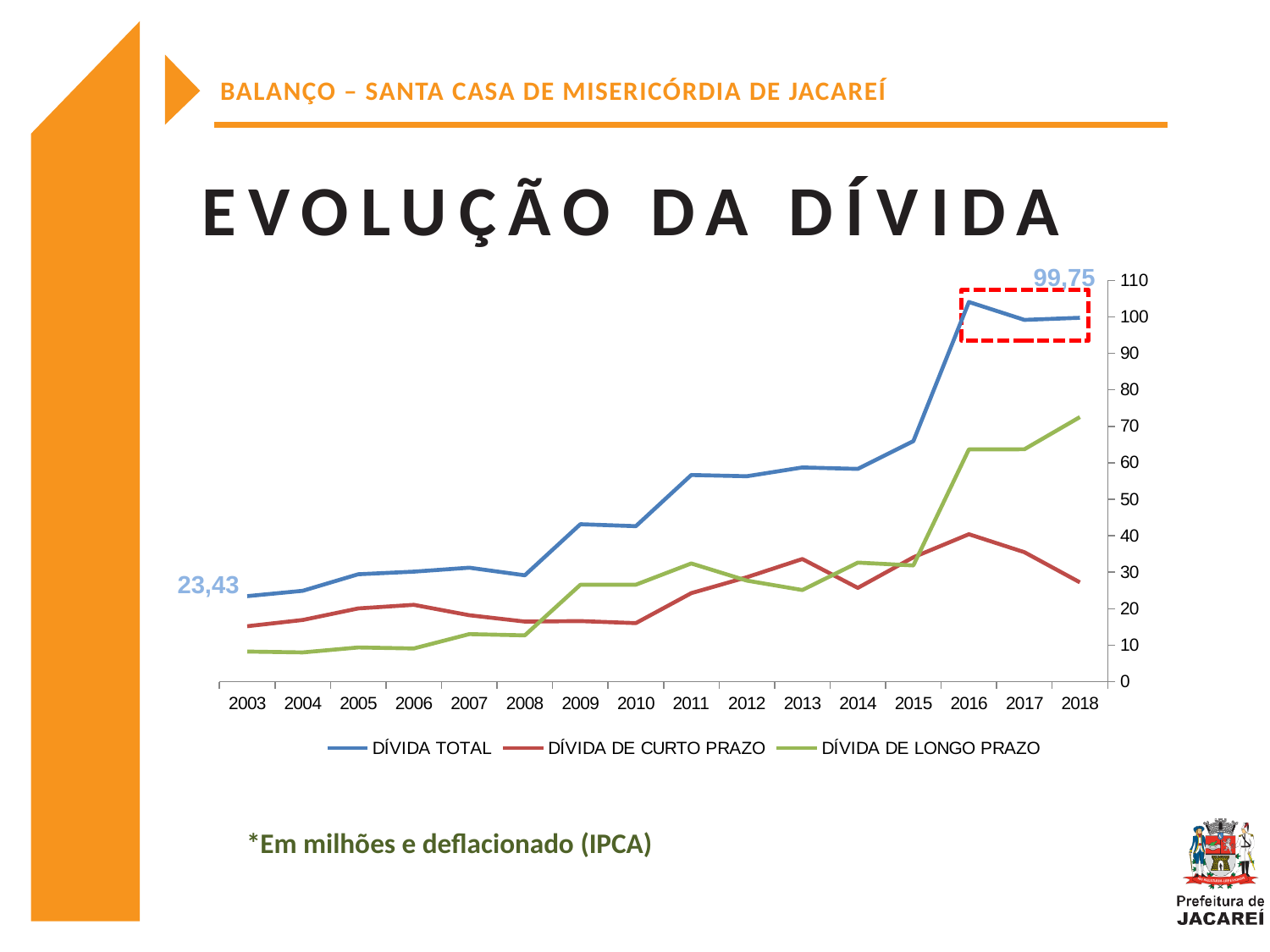
Is the value for DÍVIDA DE CURTO PRAZO in 2016 greater or less than 50? less What is the title of the chart? EVOLUÇÃO DA DÍVIDA How many years are shown on the x axis? 16 What is the value of DÍVIDA TOTAL in 2003? 23,43 Which series has the lowest value in 2003? DÍVIDA DE LONGO PRAZO By how much did DÍVIDA TOTAL increase from 2003 to 2018? 76,32 Is the value for DÍVIDA DE LONGO PRAZO in 2018 greater or less than 60? greater How many series does the legend list? 3 What kind of chart is shown on the slide? Line chart In 2018, which is larger: DÍVIDA DE CURTO PRAZO or DÍVIDA DE LONGO PRAZO? DÍVIDA DE LONGO PRAZO Does DÍVIDA TOTAL generally rise or fall from 2003 to 2018? Rise What is the value of DÍVIDA TOTAL in 2018? 99,75